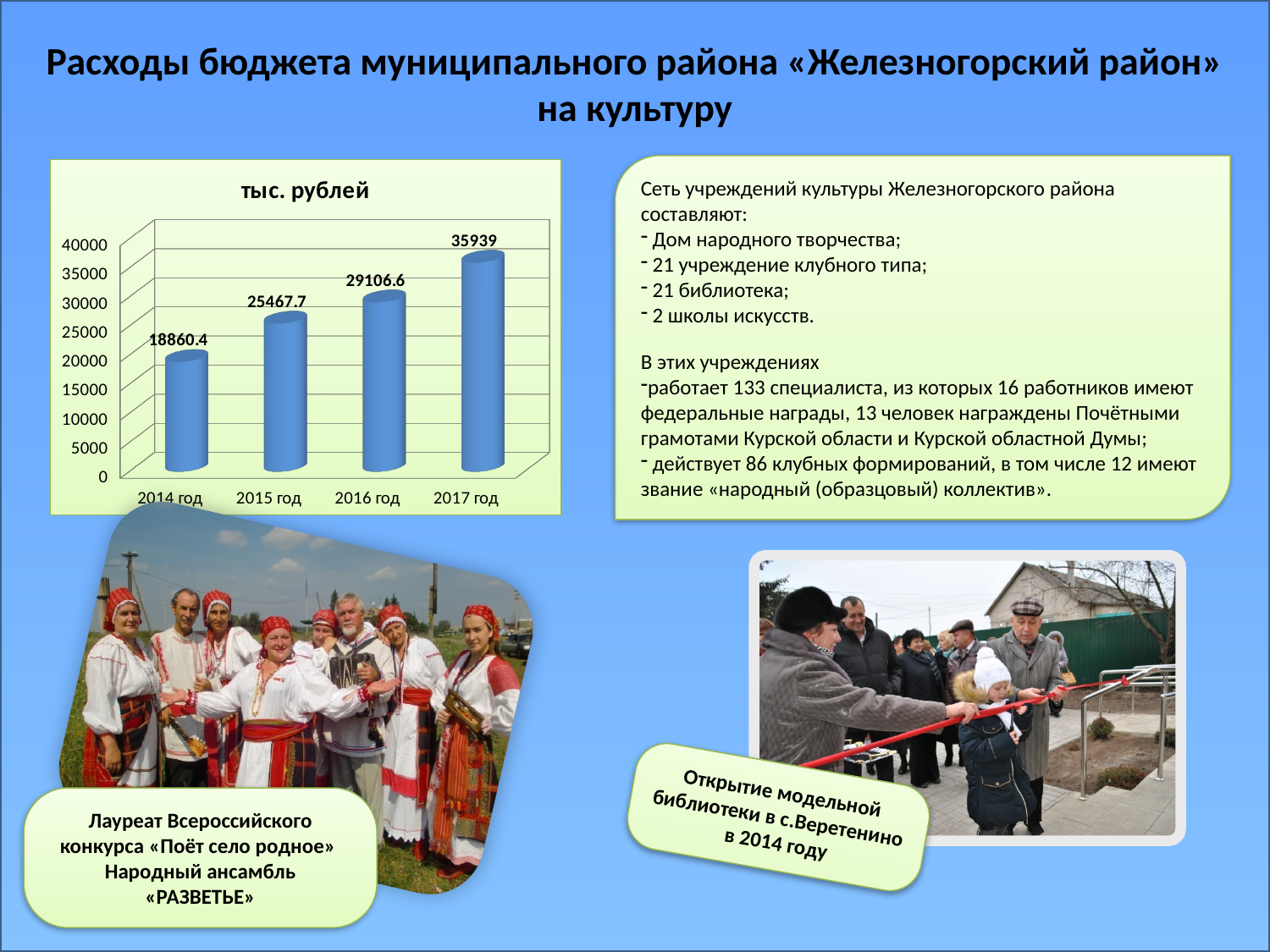
What is the value for 2014 год in the chart? 18860.4 Is the value for 2015 год greater or less than 30000? less Which is larger, the value for 2015 год or the value for 2016 год? 2016 год What is the difference between the values for 2016 год and 2015 год? 3638.9 What is the difference between the values for 2017 год and 2014 год? 17078.6 What is the value for 2017 год in the chart? 35939 Do the values rise or fall from 2014 год to 2017 год? rise What is the value for 2016 год in the chart? 29106.6 How many years are shown in the chart? 4 Which year has the lowest value in the chart? 2014 год Which year has the highest value in the chart? 2017 год What kind of chart is shown on the slide? bar chart